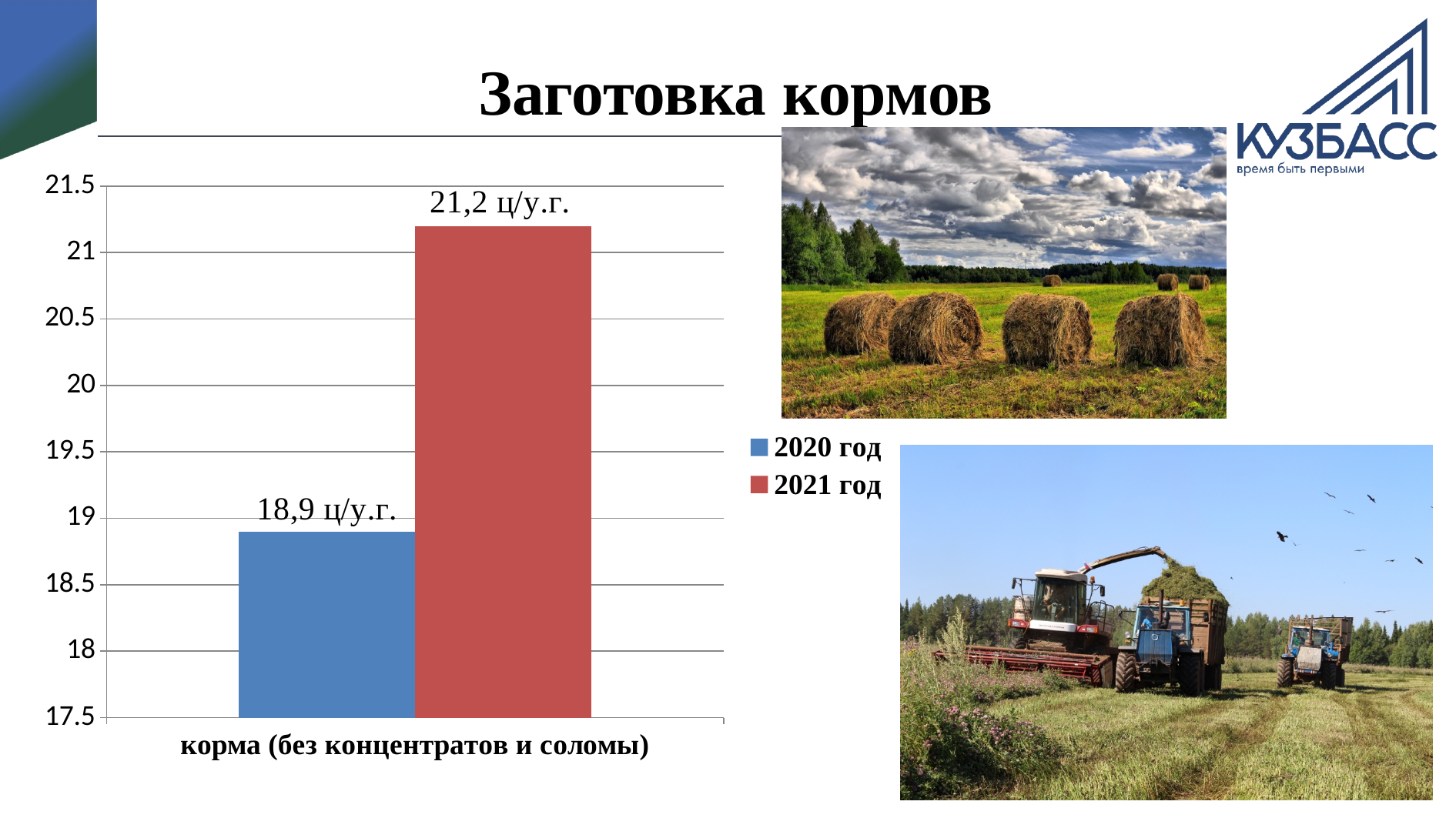
What is the value for 2021 год in the chart? 21,2 ц/у.г. Is the value for 2020 год greater or less than 19? less What is the category label on the x axis of the chart? корма (без концентратов и соломы) Which series has the lowest value in the chart? 2020 год Which series has the higher value, 2020 год or 2021 год? 2021 год What kind of chart is shown on the slide? bar chart What is the difference between the 2021 год and 2020 год values? 2,3 ц/у.г. What is the value for 2020 год in the chart? 18,9 ц/у.г. How many categories are shown on the x axis of the chart? 1 How many series does the legend list? 2 Which series has the highest value in the chart? 2021 год Is the value for 2021 год greater or less than 21? greater